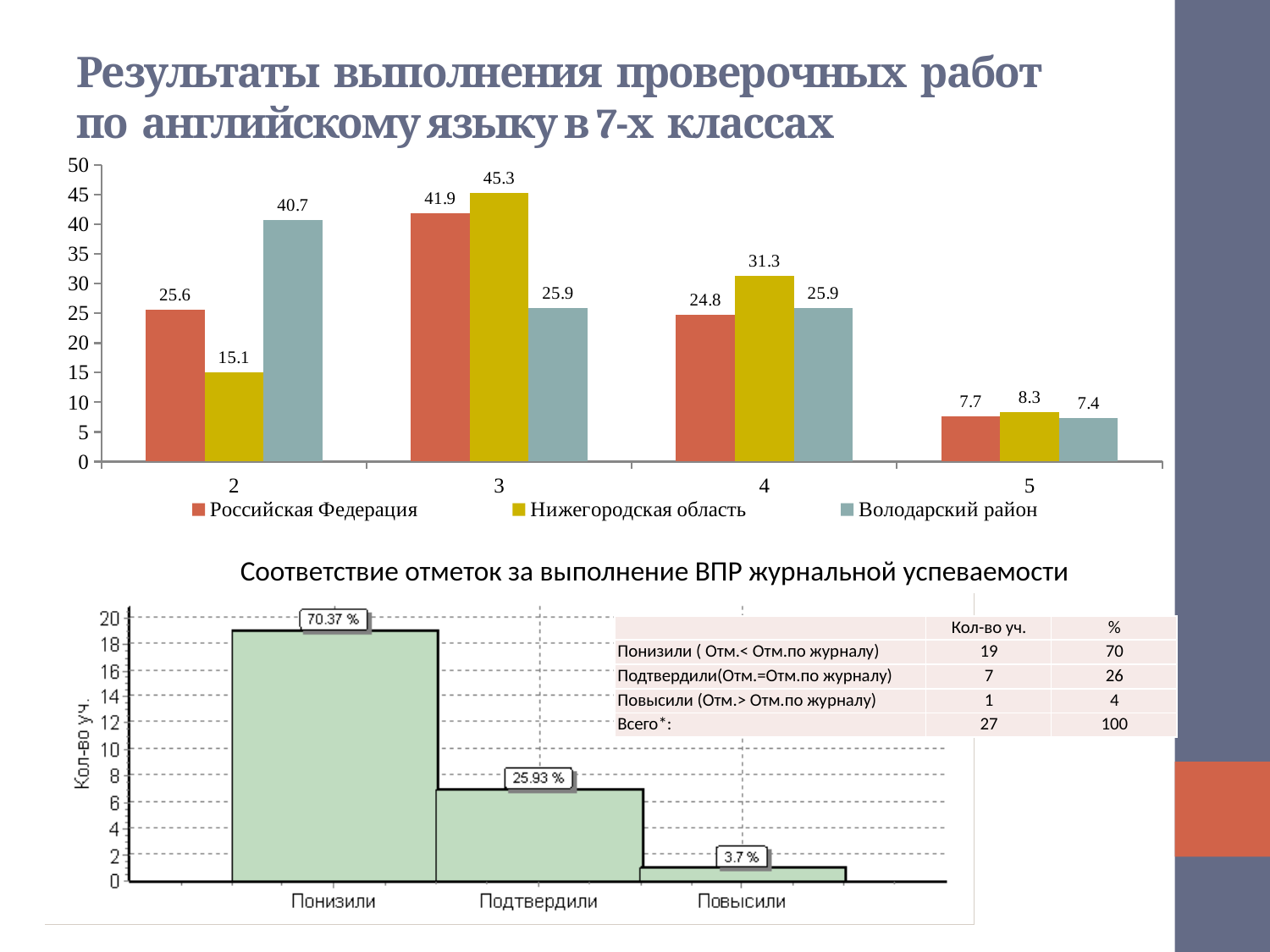
How many categories are shown on the x axis of the top chart? 4 In the top chart, what is the value for Нижегородская область for category 3? 45.3 In the top chart, what is the value for Володарский район for category 2? 40.7 How many series does the legend of the top chart list? 3 In the top chart, what is the difference between Нижегородская область and Российская Федерация for category 2? 10.5 In the chart titled 'Соответствие отметок за выполнение ВПР журнальной успеваемости', what percentage is shown for Подтвердили? 25.93 % In the top chart, which category has the highest value for Российская Федерация? 3 What kind of chart is the chart titled 'Соответствие отметок за выполнение ВПР журнальной успеваемости'? bar chart In the top chart, for category 4, which is larger: Нижегородская область or Володарский район? Нижегородская область In the chart titled 'Соответствие отметок за выполнение ВПР журнальной успеваемости', which category has the highest bar? Понизили In the top chart, which category has the lowest value for Володарский район? 5 In the top chart, what is the value for Российская Федерация for category 4? 24.8